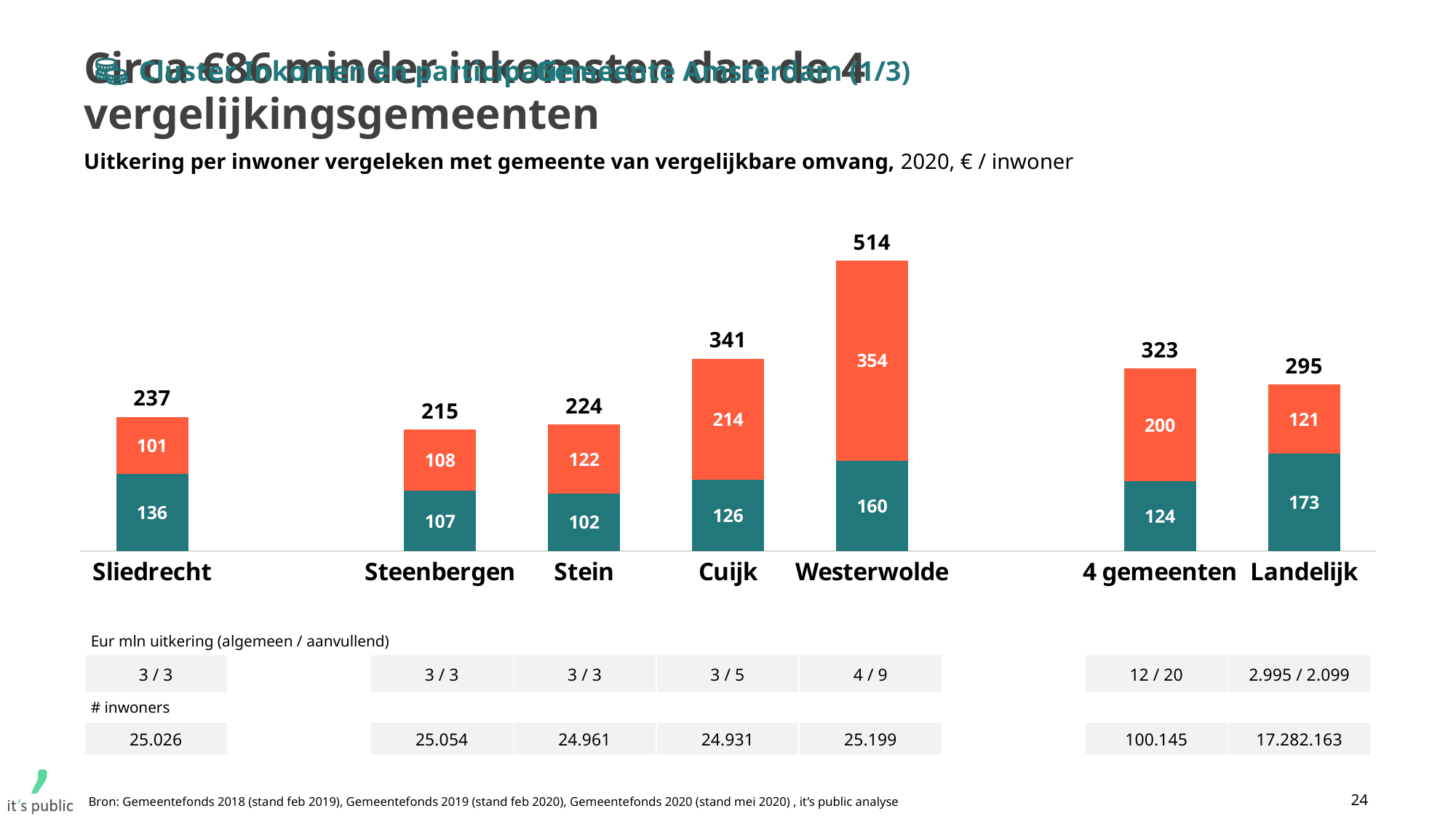
Which category has the highest total bar value? Westerwolde Which category has the lowest total bar value? Steenbergen What unit is stated in the chart subtitle for the plotted values? € / inwoner How many categories are shown on the x axis of the chart? 7 What is the difference between the total for Westerwolde and the total for Cuijk? 173 What is the sum of the two segments of the Stein bar (102 and 122)? 224 What is the value of the orange (top) segment of the Cuijk bar? 214 What is the value of the teal (bottom) segment of the Sliedrecht bar? 136 What is the total value printed above the bar for Landelijk? 295 What kind of chart is shown on the slide? Stacked bar chart Which has a larger total value, 4 gemeenten or Landelijk? 4 gemeenten What is the total value printed above the bar for Westerwolde? 514